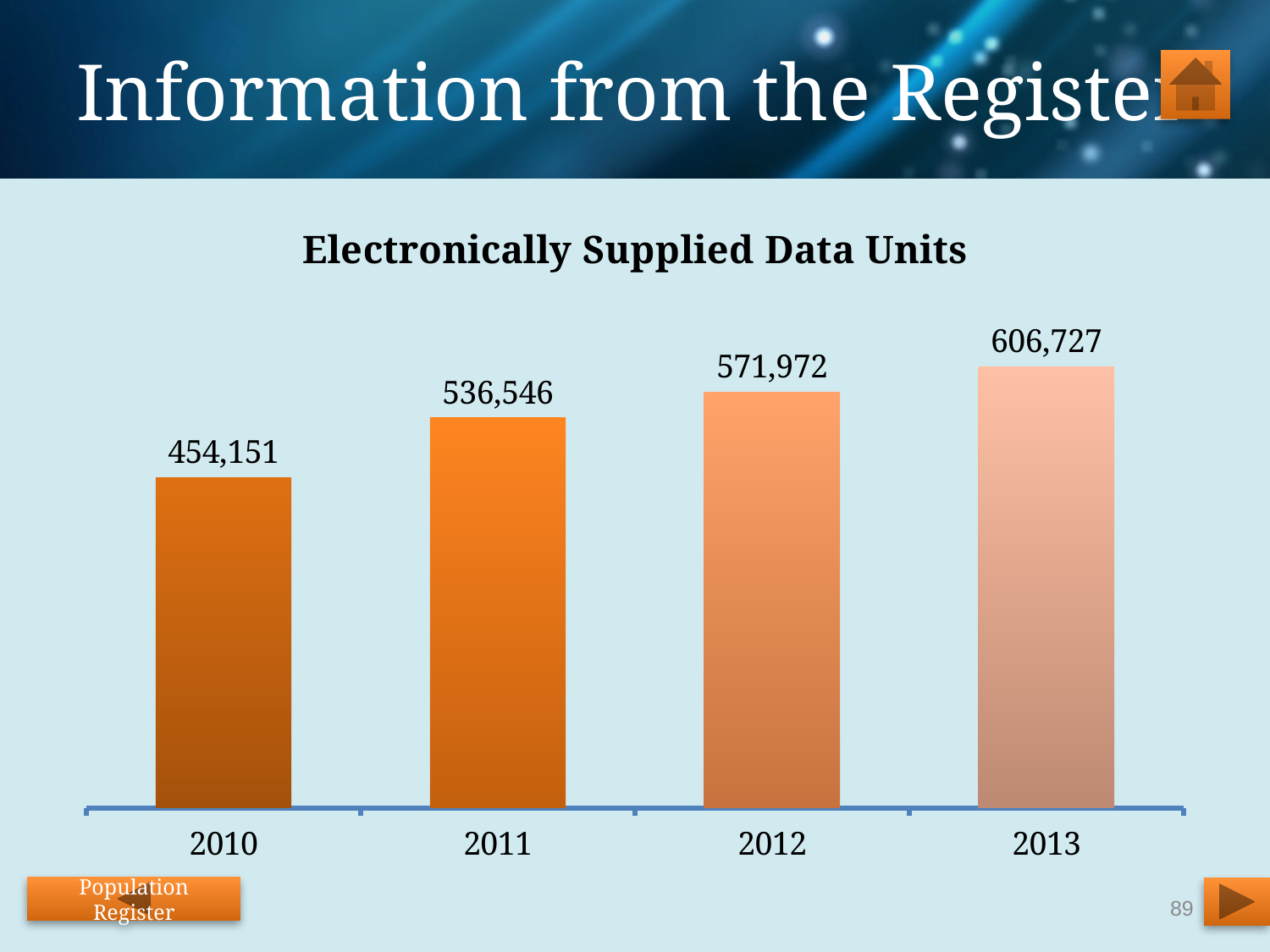
What is the difference between the values for 2011 and 2010? 82,395 Do the values rise or fall from 2010 to 2013? rise What is the title of the chart? Electronically Supplied Data Units What is the difference between the values for 2013 and 2010? 152,576 What is the value for 2010? 454,151 Which year has the highest value? 2013 What is the value for 2013? 606,727 How many years are shown on the x axis? 4 What is the value for 2012? 571,972 What kind of chart is shown? bar chart Which year has the lowest value? 2010 Which is larger, the value for 2011 or the value for 2012? 2012